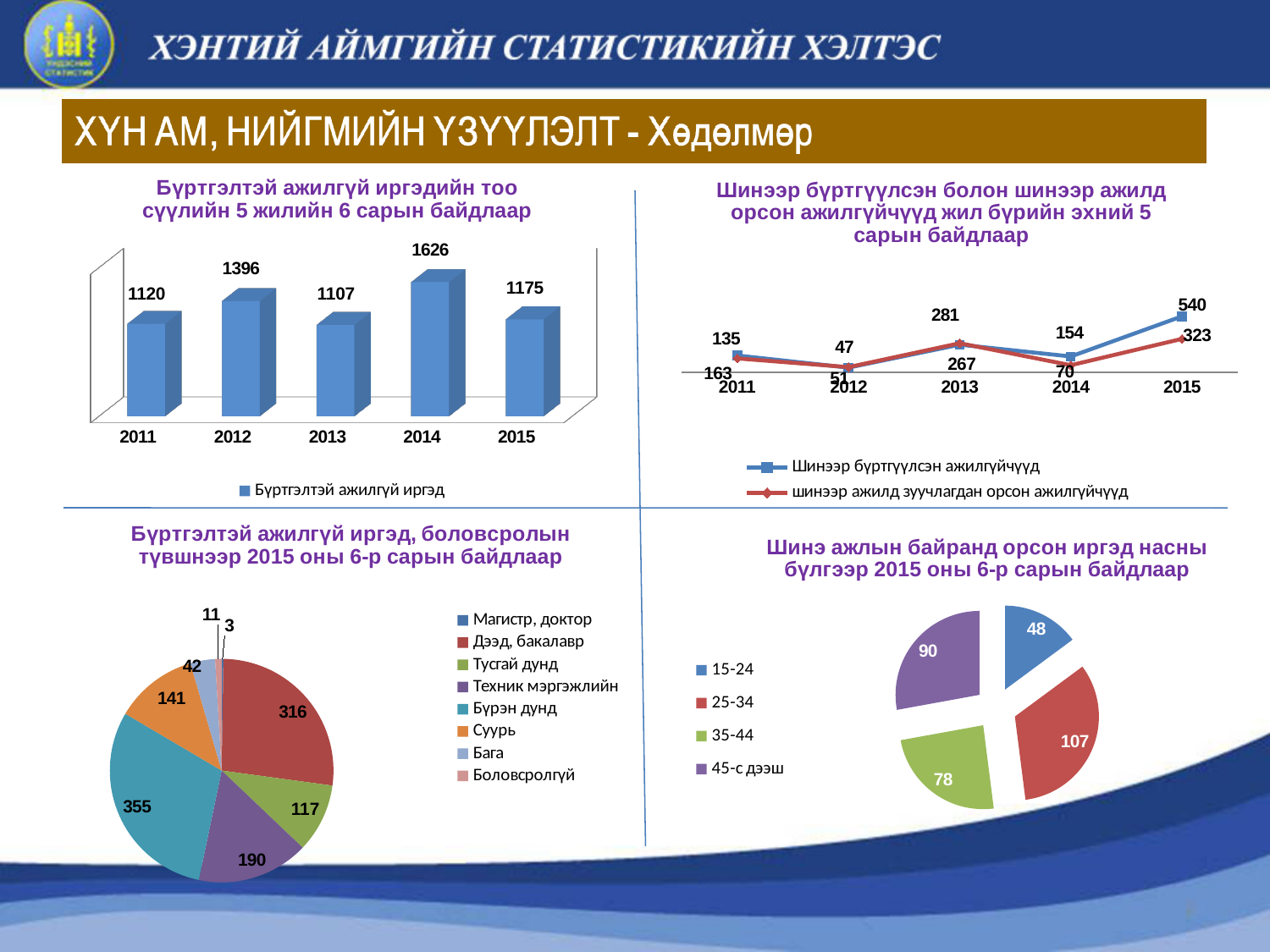
In the bar chart 'Бүртгэлтэй ажилгүй иргэдийн тоо сүүлийн 5 жилийн 6 сарын байдлаар', what is the difference between the 2014 and 2015 values? 451 In the bar chart 'Бүртгэлтэй ажилгүй иргэдийн тоо сүүлийн 5 жилийн 6 сарын байдлаар', what is the value for 2014? 1626 In the line chart 'Шинээр бүртгүүлсэн болон шинээр ажилд орсон ажилгүйчүүд', which year has the highest value for 'Шинээр бүртгүүлсэн ажилгүйчүүд'? 2015 What kind of chart is the top-left chart 'Бүртгэлтэй ажилгүй иргэдийн тоо сүүлийн 5 жилийн 6 сарын байдлаар'? Bar chart In the pie chart 'Бүртгэлтэй ажилгүй иргэд, боловсролын түвшнээр 2015 оны 6-р сарын байдлаар', what is the value for 'Бүрэн дунд'? 355 In the pie chart 'Шинэ ажлын байранд орсон иргэд насны бүлгээр 2015 оны 6-р сарын байдлаар', which age group has the largest slice? 25-34 In the bar chart 'Бүртгэлтэй ажилгүй иргэдийн тоо сүүлийн 5 жилийн 6 сарын байдлаар', how many years are shown? 5 In the line chart 'Шинээр бүртгүүлсэн болон шинээр ажилд орсон ажилгүйчүүд', what is the value of 'Шинээр бүртгүүлсэн ажилгүйчүүд' in 2015? 540 In the line chart 'Шинээр бүртгүүлсэн болон шинээр ажилд орсон ажилгүйчүүд', what is the value of 'шинээр ажилд зуучлагдан орсон ажилгүйчүүд' in 2015? 323 In the bar chart 'Бүртгэлтэй ажилгүй иргэдийн тоо сүүлийн 5 жилийн 6 сарын байдлаар', which year has the lowest value? 2013 How many series does the legend of the line chart 'Шинээр бүртгүүлсэн болон шинээр ажилд орсон ажилгүйчүүд' list? 2 In the pie chart 'Шинэ ажлын байранд орсон иргэд насны бүлгээр 2015 оны 6-р сарын байдлаар', what is the value for the '45-с дээш' group? 90